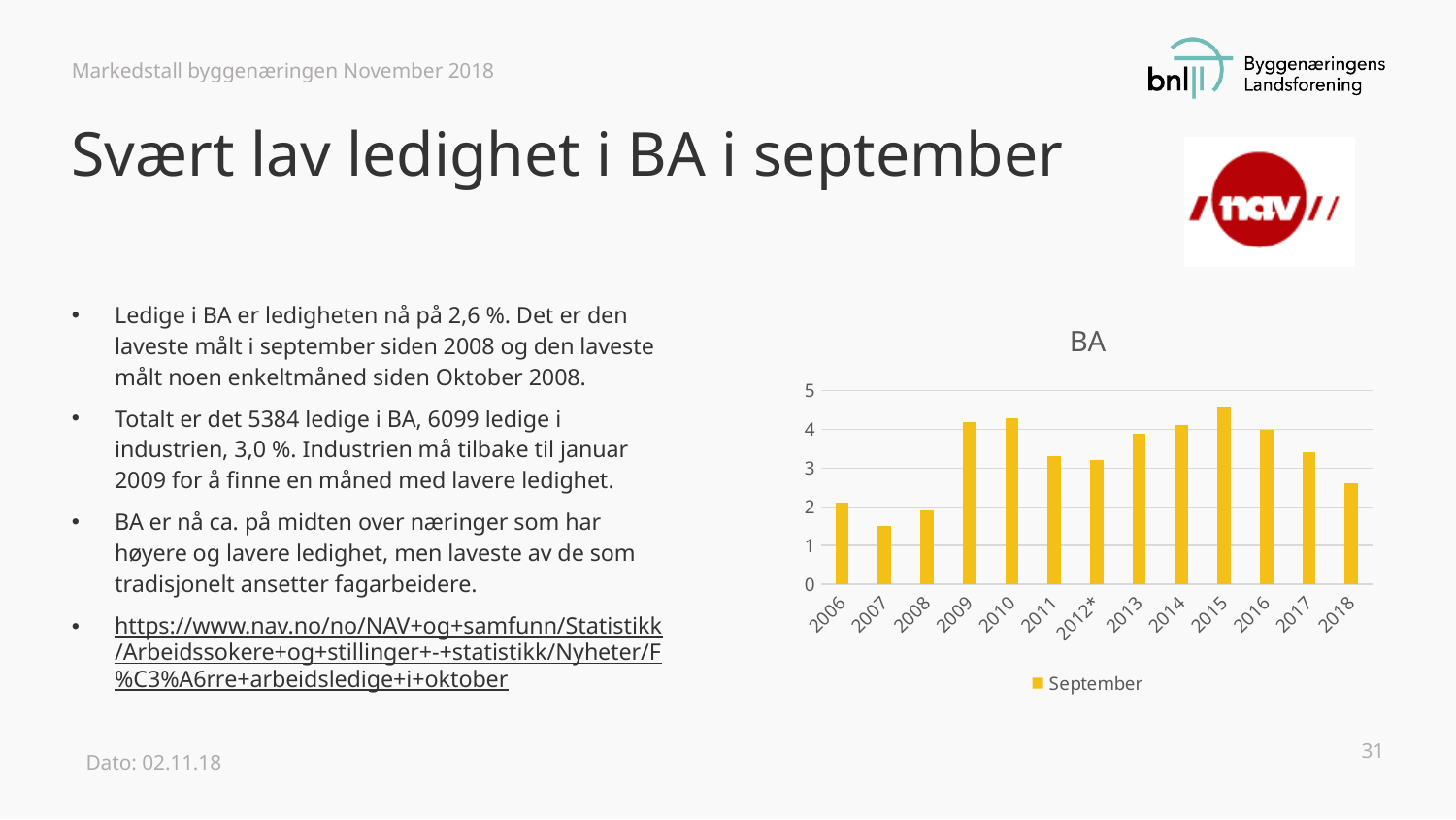
Is the value for 2009 greater or less than 4? greater How many years (categories) are shown on the x axis of the chart? 13 Which is larger, the value for 2017 or the value for 2018? 2017 Is the value for 2007 greater or less than 2? less What kind of chart is shown on the slide? bar chart What is the name of the series shown in the legend? September Which year has the highest bar in the chart? 2015 How many series does the chart legend list? 1 Do the values rise or fall from 2015 to 2018? fall What is the title of the chart? BA Which year has the lowest bar in the chart? 2007 Is the value for 2018 greater or less than 3? less